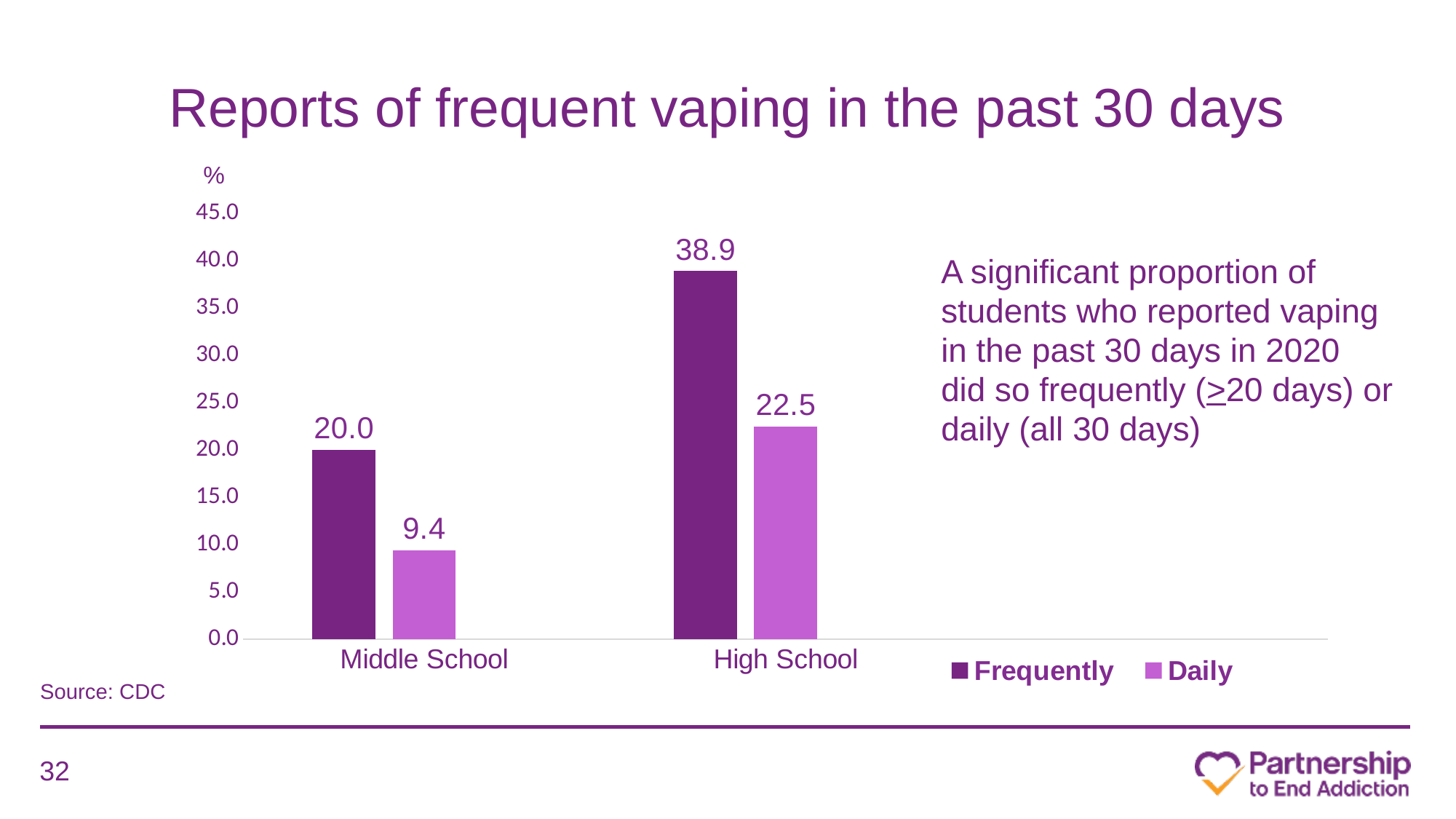
What is the value for Daily for Middle School? 9.4 What is the difference between the Frequently and Daily values for High School? 16.4 Which bar has the highest value on the chart? High School, Frequently Which bar has the lowest value on the chart? Middle School, Daily How many series does the legend list? 2 What is the value for Frequently for Middle School? 20.0 Which is larger, the Daily value for High School or the Frequently value for Middle School? Daily value for High School How many categories are shown on the x axis? 2 What is the value for Daily for High School? 22.5 What is the value for Frequently for High School? 38.9 What kind of chart is shown on the slide? Bar chart What is the difference between the Frequently values for High School and Middle School? 18.9